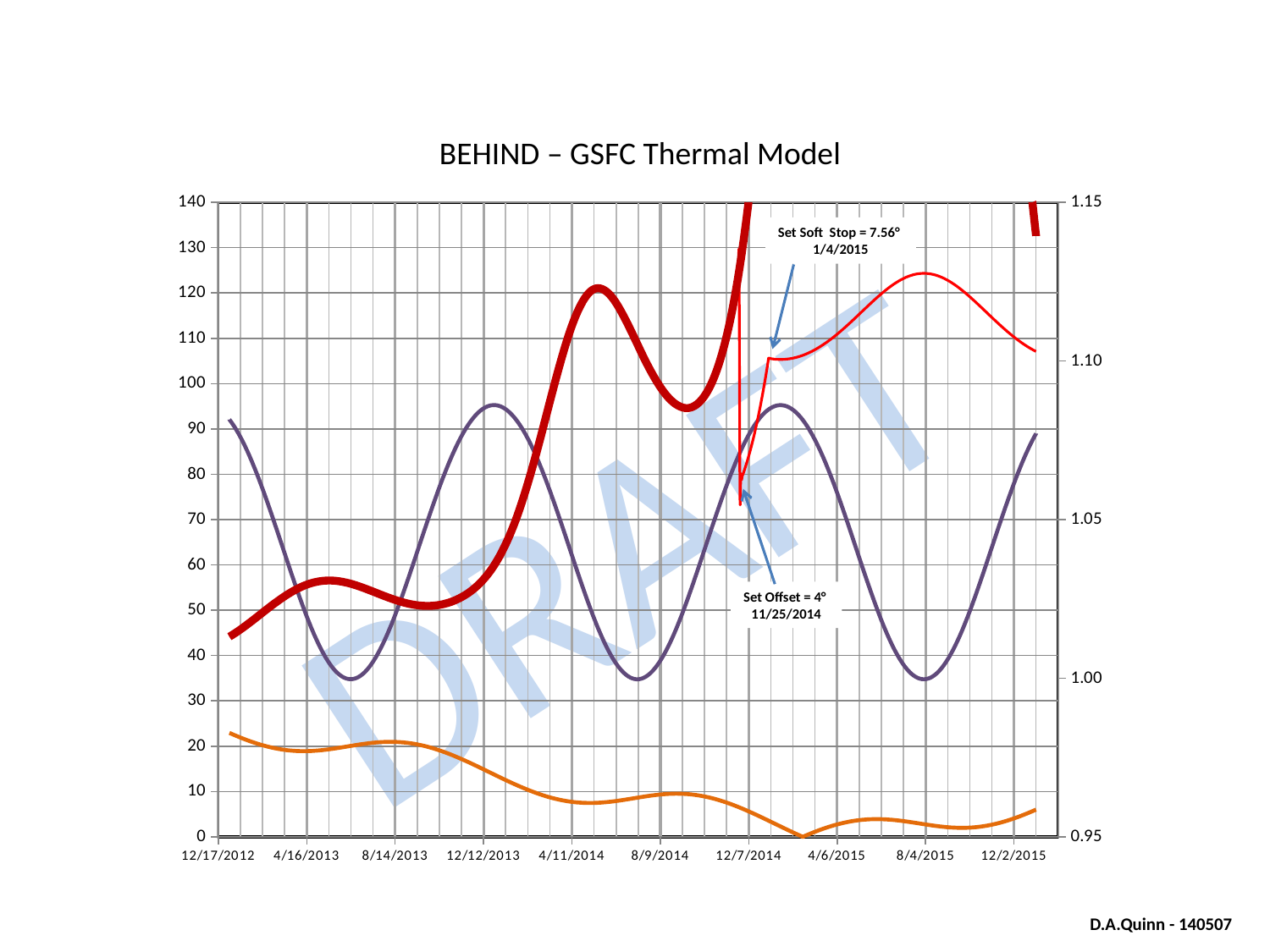
What is the title of the chart? BEHIND – GSFC Thermal Model How many date labels are shown on the x axis? 10 According to the annotation, what offset value is set on 11/25/2014? 4° Is the minimum of the purple line near 8/4/2015 greater or less than 40 on the left axis? less Is the value of the thick red line at 12/17/2012 greater or less than 50 on the left axis? less According to the annotation, what soft stop value is set on 1/4/2015? 7.56° Is the value of the orange line at 12/17/2012 greater or less than 30 on the left axis? less Does the orange line overall rise or fall from 12/17/2012 to 12/2/2015? fall At 12/17/2012, which line is higher, the purple line or the orange line? purple line What kind of chart is shown on the slide? line chart